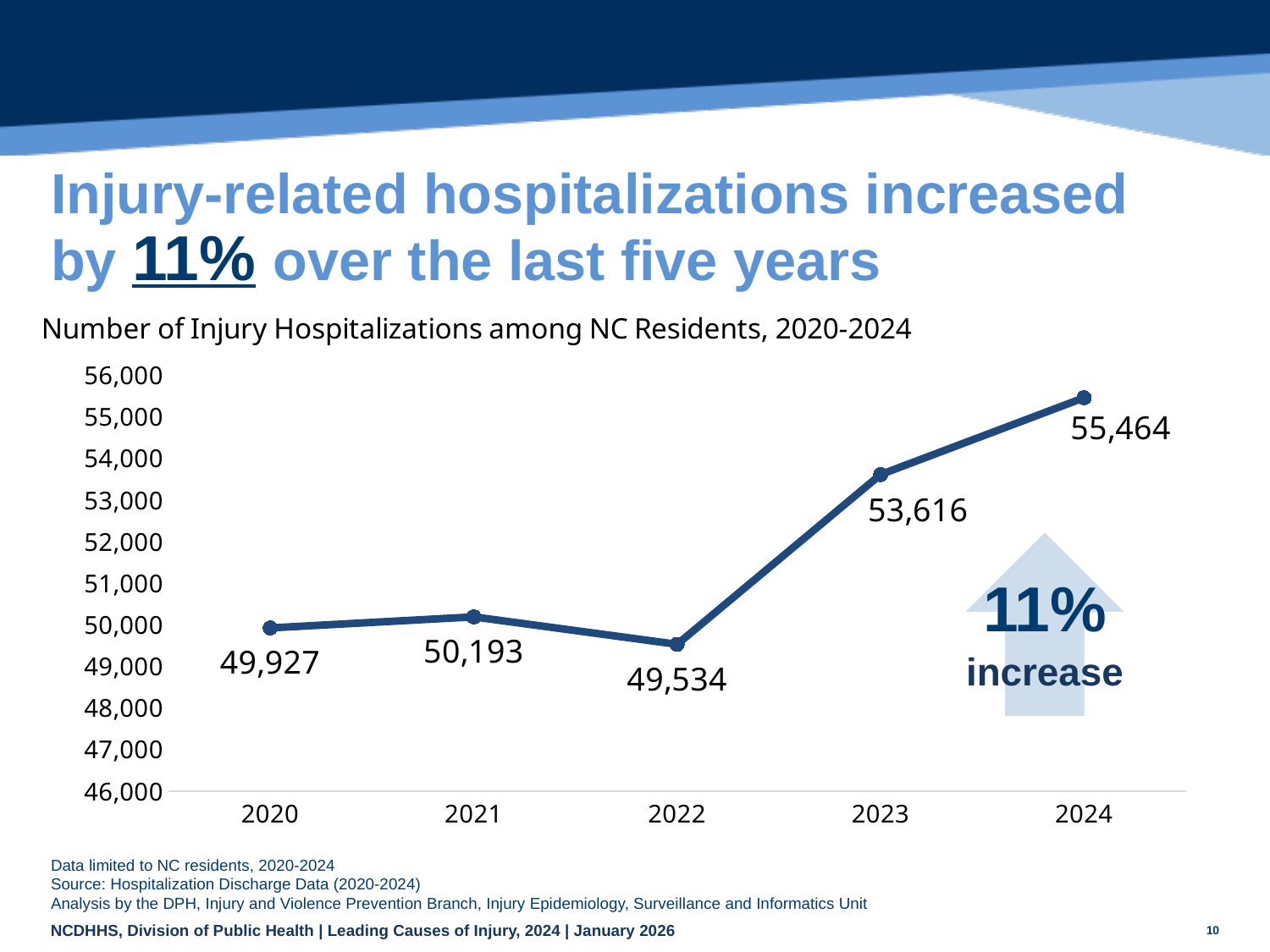
What is the difference in injury hospitalizations between 2024 and 2020? 5,537 What is the number of injury hospitalizations in 2020? 49,927 What is the difference in injury hospitalizations between 2023 and 2022? 4,082 What is the number of injury hospitalizations in 2024? 55,464 What kind of chart is shown on the slide? Line chart What is the title of the chart? Number of Injury Hospitalizations among NC Residents, 2020-2024 Which year had more injury hospitalizations, 2021 or 2023? 2023 Which year has the highest number of injury hospitalizations? 2024 What is the number of injury hospitalizations in 2022? 49,534 Is the value for 2023 greater or less than 52,000? greater Which year has the lowest number of injury hospitalizations? 2022 How many years are plotted on the chart? 5